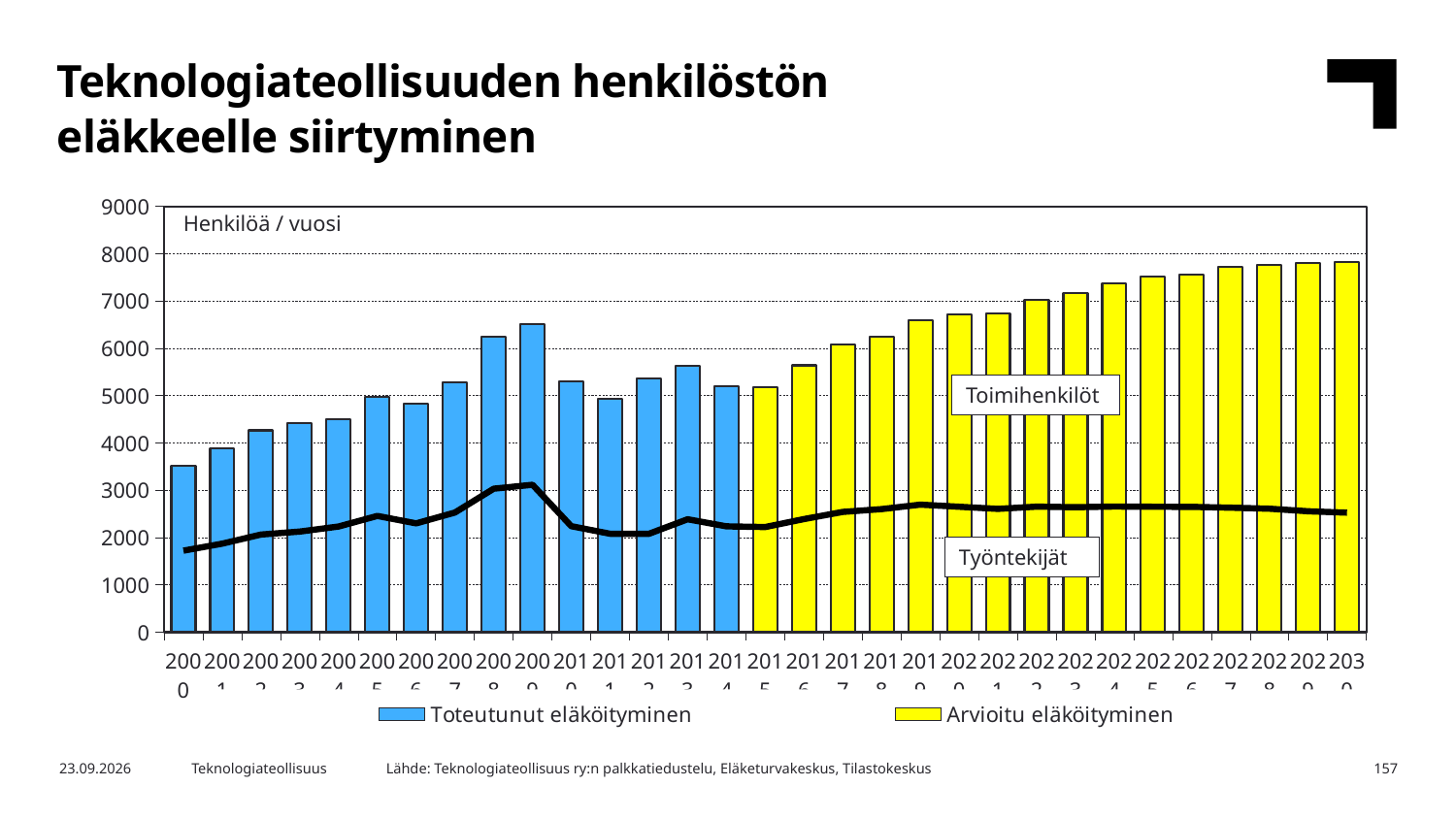
Among the blue 'Toteutunut eläköityminen' bars, which year is highest? 2009 What kind of chart is shown on the slide? Bar chart (with a line) Do the yellow 'Arvioitu eläköityminen' bars rise or fall from 2015 to 2030? rise Which year has the lowest bar? 2000 Is the bar for 2009 greater or less than 6000? greater Is the bar for 2000 greater or less than 4000? less Which bar is taller, 2008 or 2009? 2009 What unit label is shown at the top left inside the plot area? Henkilöä / vuosi How many entries does the legend list? 2 Is the bar for 2030 greater or less than 7000? greater How many years (bars) are plotted along the x axis? 31